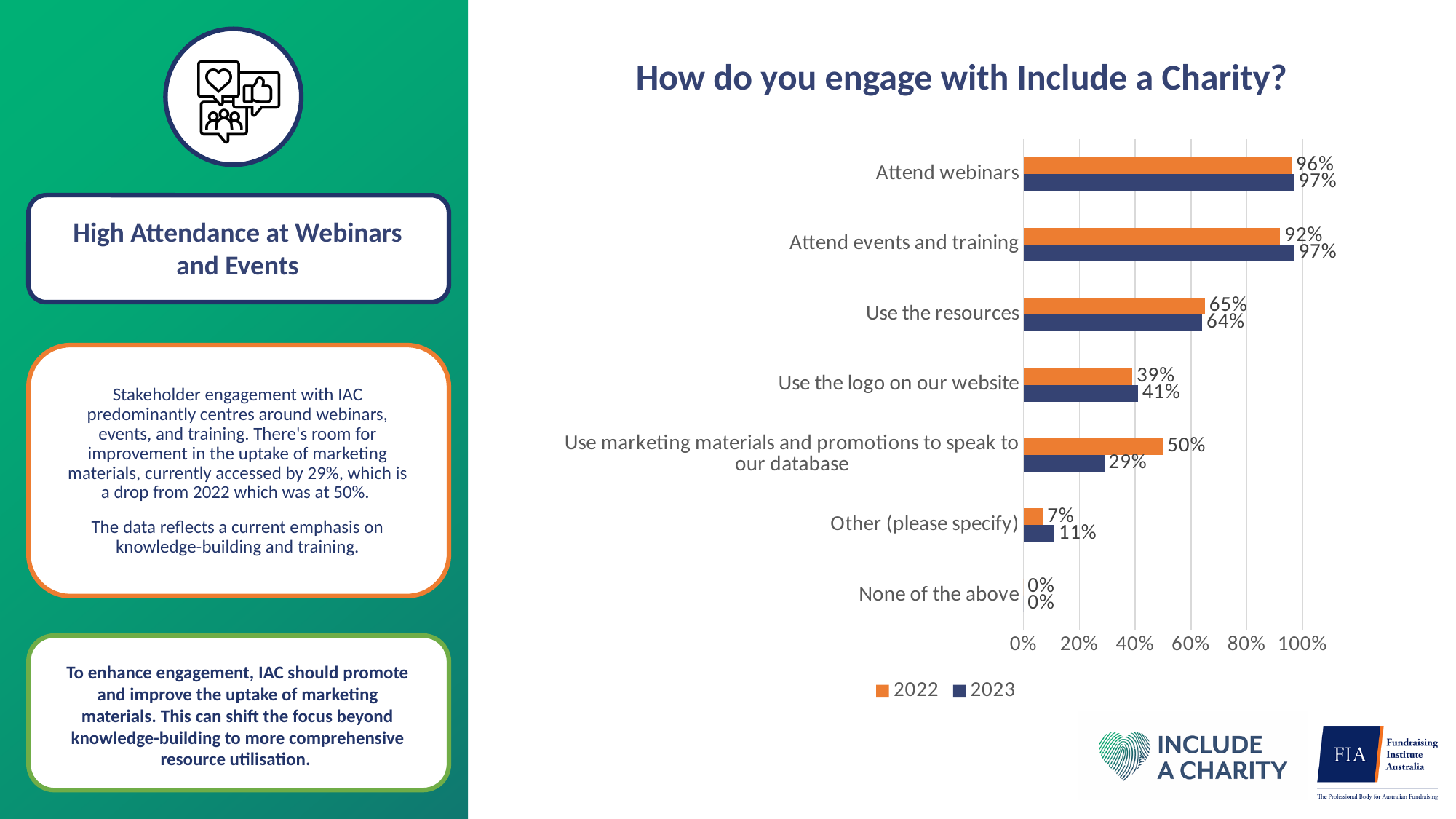
What kind of chart is shown on the slide? Bar chart What is the difference between the 2022 and 2023 values for Use marketing materials and promotions to speak to our database? 21% How many categories are shown on the chart? 7 How many series does the legend list? 2 What is the 2022 value for Use marketing materials and promotions to speak to our database? 50% What is the 2023 value for Use the logo on our website? 41% What is the difference between the 2022 and 2023 values for Attend events and training? 5% What is the 2022 value for Other (please specify)? 7% What is the 2023 value for Attend webinars? 97% Which category has the lowest 2023 value? None of the above Which category has the highest 2022 value? Attend webinars For Other (please specify), which year has the larger value, 2022 or 2023? 2023